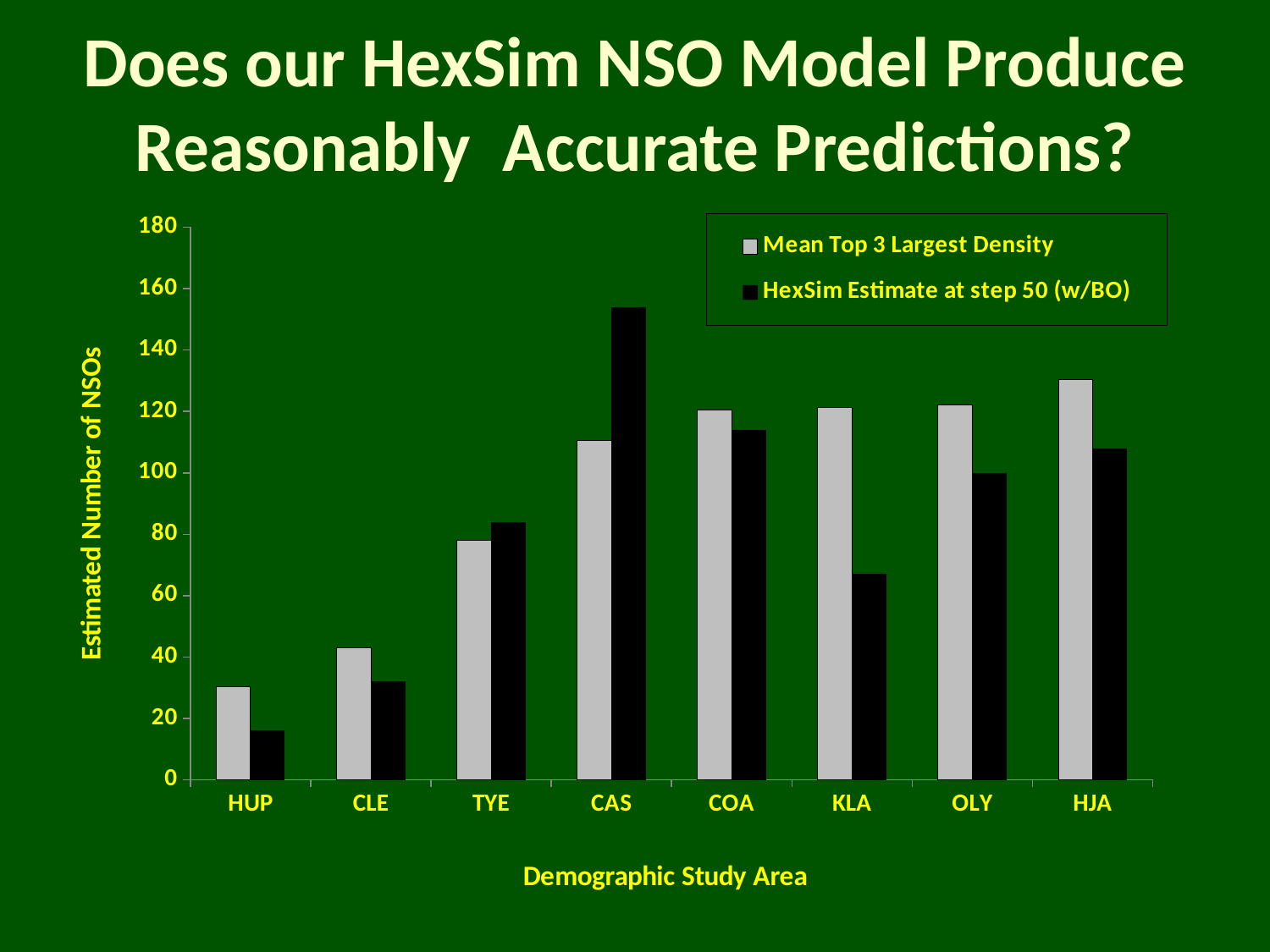
Is the HexSim Estimate at step 50 (w/BO) for CAS greater or less than 140? greater Which study area has the highest HexSim Estimate at step 50 (w/BO)? CAS For KLA, which is larger: the Mean Top 3 Largest Density or the HexSim Estimate at step 50 (w/BO)? Mean Top 3 Largest Density Which study area has the lowest HexSim Estimate at step 50 (w/BO)? HUP Is the HexSim Estimate at step 50 (w/BO) for KLA greater or less than 80? less Which study area has the highest Mean Top 3 Largest Density? HJA Which study area has the lowest Mean Top 3 Largest Density? HUP What kind of chart is shown on the slide? bar chart How many series does the legend list? 2 How many demographic study areas are shown on the x axis? 8 Is the Mean Top 3 Largest Density for HJA greater or less than 120? greater What is the title of the x axis? Demographic Study Area